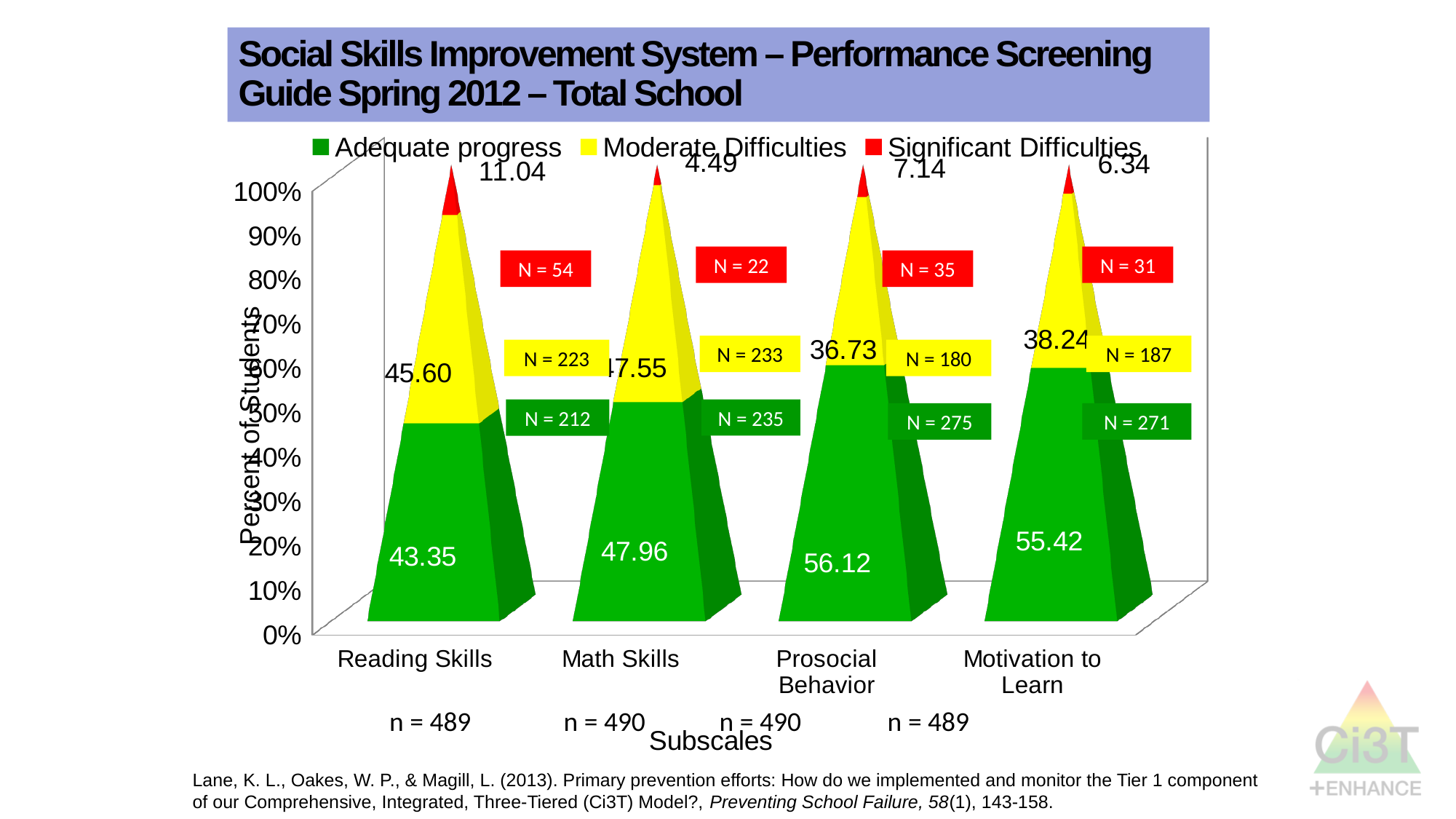
Which subscale has the lowest Significant Difficulties value? Math Skills How many series does the legend list? 3 How many subscales are shown on the x axis? 4 What is the N value shown for Significant Difficulties in Reading Skills? N = 54 What is the Moderate Difficulties value for Prosocial Behavior? 36.73 Which subscale has the highest Adequate progress value? Prosocial Behavior Which is larger: the Significant Difficulties value for Reading Skills or for Prosocial Behavior? Reading Skills What is the Significant Difficulties value for Math Skills? 4.49 What is the difference between the Moderate Difficulties and Adequate progress values for Reading Skills? 2.25 What is the Adequate progress value for Motivation to Learn? 55.42 What is the Adequate progress value for Reading Skills? 43.35 Which subscale has the highest Significant Difficulties value? Reading Skills